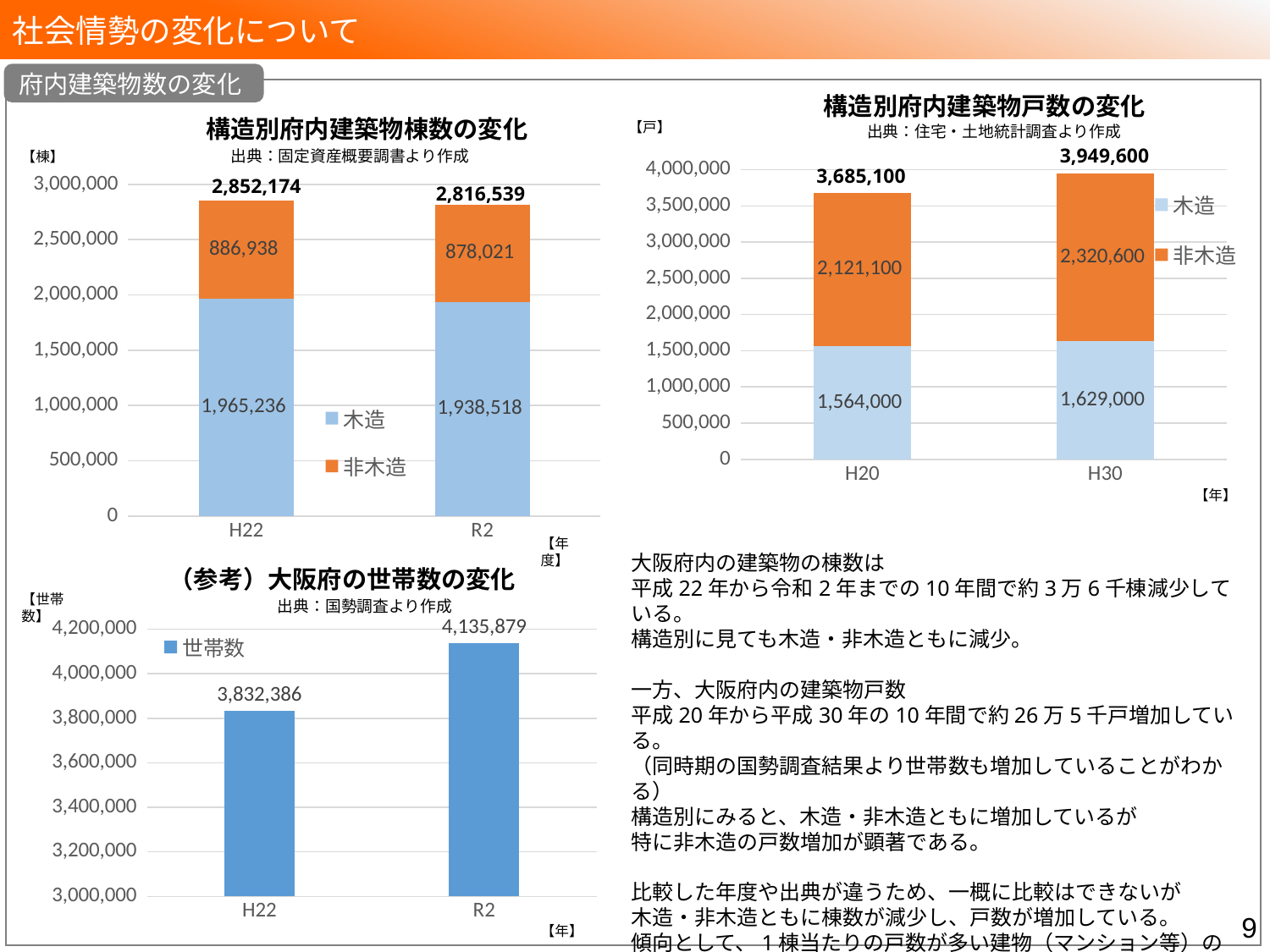
In the chart titled （参考）大阪府の世帯数の変化, what is the value for R2? 4,135,879 In the chart titled 構造別府内建築物戸数の変化, what is the value for 非木造 in H30? 2,320,600 What kind of chart is the one titled （参考）大阪府の世帯数の変化? bar chart In the chart titled （参考）大阪府の世帯数の変化, what is the difference between the R2 and H22 values? 303,493 In the chart titled 構造別府内建築物棟数の変化, what is the difference between the 木造 values for H22 and R2? 26,718 In the chart titled 構造別府内建築物棟数の変化, what is the value for 非木造 in R2? 878,021 In the chart titled 構造別府内建築物棟数の変化, what is the value for 木造 in H22? 1,965,236 In the chart titled 構造別府内建築物戸数の変化, what is the total of the stacked bar for H20? 3,685,100 In the chart titled 構造別府内建築物棟数の変化, what is the total of the stacked bar for R2? 2,816,539 In the chart titled 構造別府内建築物戸数の変化, how many series does the legend list? 2 In the chart titled 構造別府内建築物戸数の変化, which is larger, the 木造 value for H20 or for H30? H30 In the chart titled （参考）大阪府の世帯数の変化, do the values rise or fall from H22 to R2? rise